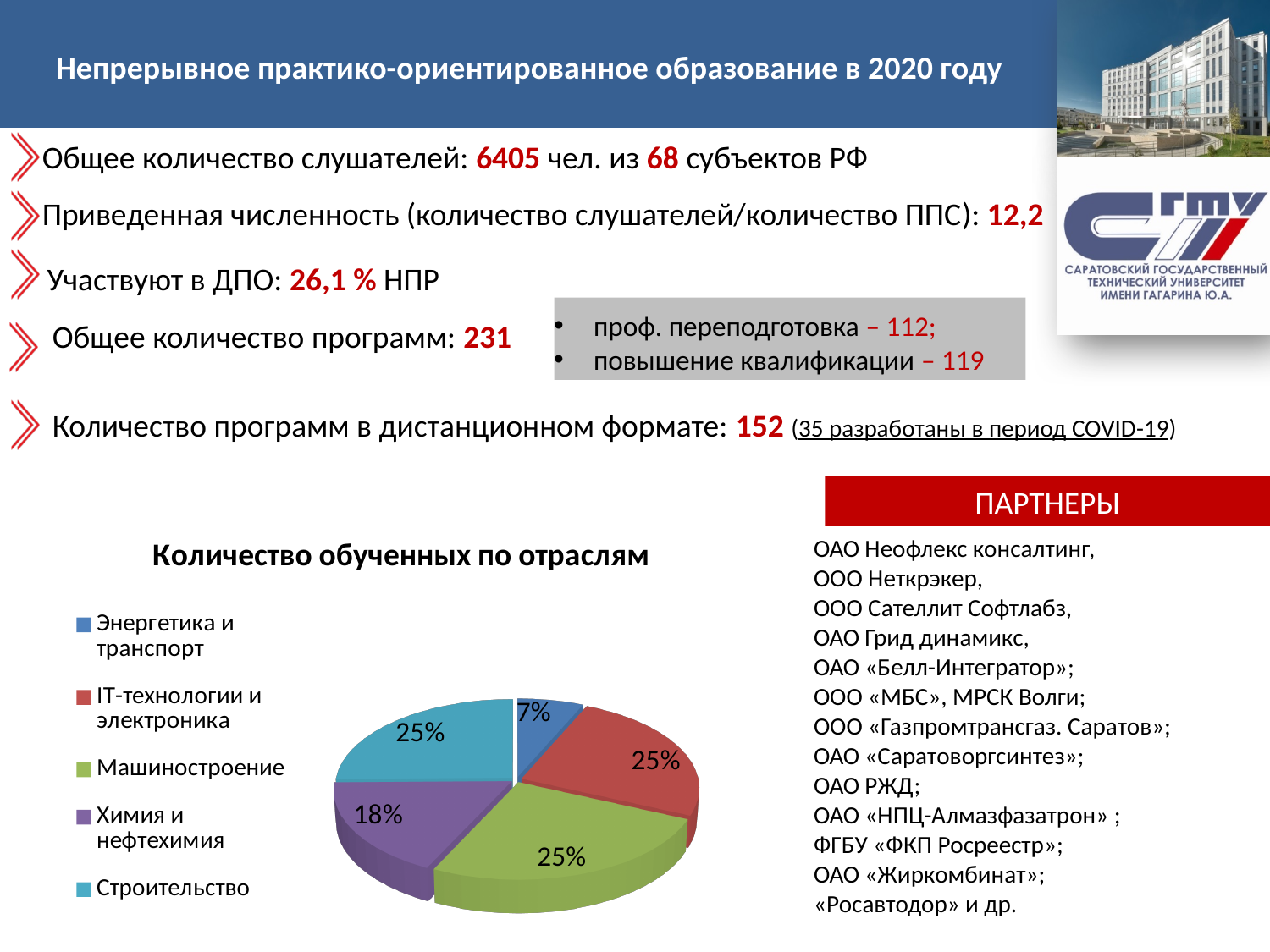
What is the difference between the shares of Машиностроение and Химия и нефтехимия? 7% What is the title of the chart? Количество обученных по отраслям What is the value shown for Машиностроение? 25% What is the value shown for Строительство? 25% Which category has the smallest slice of the pie? Энергетика и транспорт What share of the pie does Химия и нефтехимия hold? 18% What is the difference between the shares of Строительство and Энергетика и транспорт? 18% What share of the pie does Энергетика и транспорт hold? 7% What kind of chart is shown on the slide? Pie chart How many categories are shown in the pie chart? 5 Which is larger, the share for Химия и нефтехимия or the share for Энергетика и транспорт? Химия и нефтехимия What is the value shown for IT-технологии и электроника? 25%